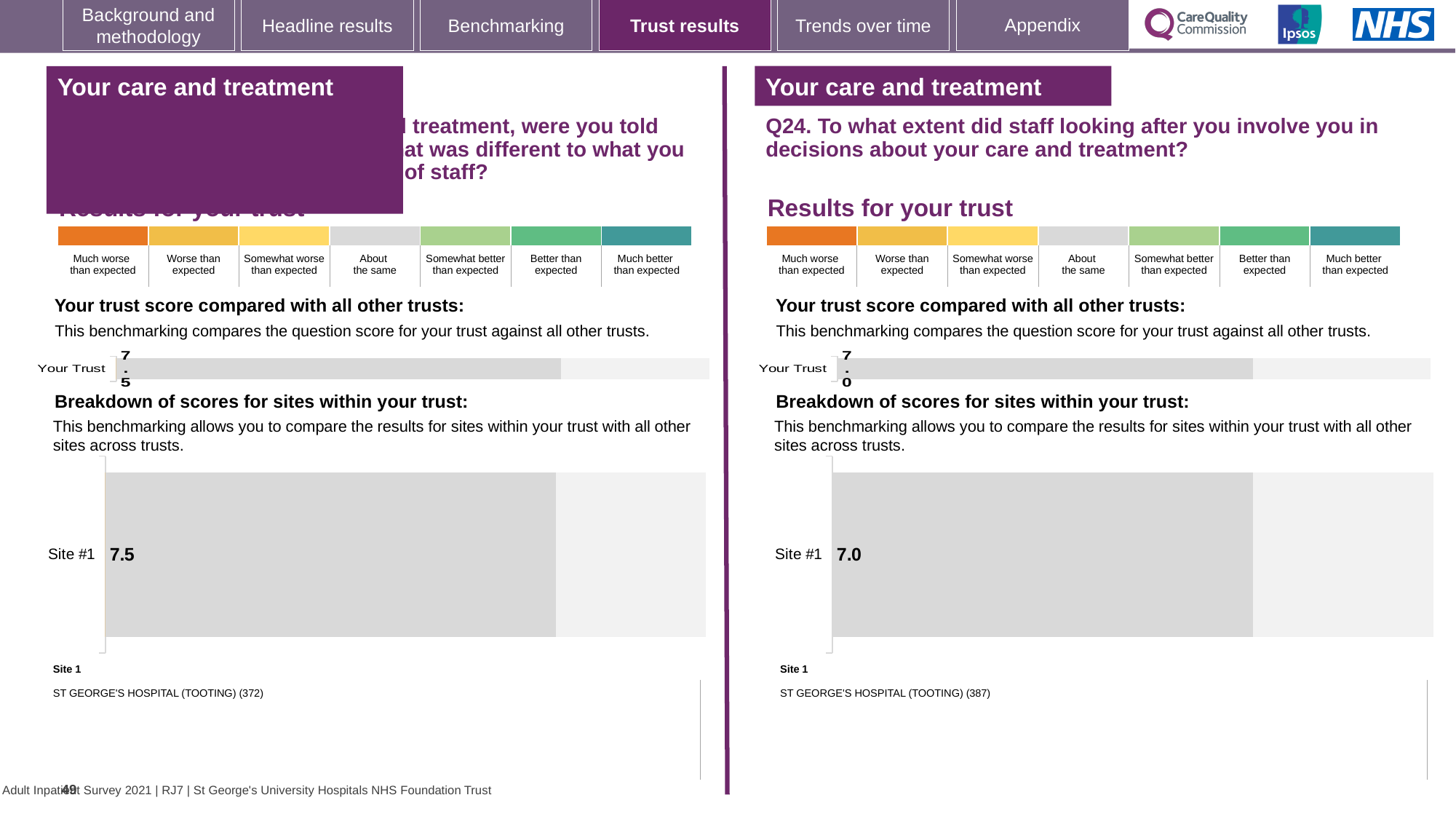
How many sites are plotted in the right-hand (Q24) 'Breakdown of scores for sites within your trust' chart? 1 What is the difference between the Site #1 score in the left-hand site breakdown chart (7.5) and the Site #1 score in the right-hand (Q24) site breakdown chart (7.0)? 0.5 In the right-hand (Q24) 'Your trust score compared with all other trusts' chart, what is the value for Your Trust? 7.0 What kind of chart is used for the 'Your trust score compared with all other trusts' section on the right-hand (Q24) side? Bar chart How many sites are plotted in the left-hand 'Breakdown of scores for sites within your trust' chart? 1 In the right-hand (Q24) site breakdown, what number is shown in brackets after ST GEORGE'S HOSPITAL (TOOTING) for Site 1? 387 In the left-hand 'Breakdown of scores for sites within your trust' chart, what is the score for Site #1? 7.5 In the right-hand (Q24) site breakdown, which hospital is listed as Site 1? ST GEORGE'S HOSPITAL (TOOTING) Which is larger: the Your Trust value in the left-hand trust score chart or the Your Trust value in the right-hand (Q24) trust score chart? Left-hand chart (7.5) In the right-hand (Q24) 'Breakdown of scores for sites within your trust' chart, what is the score for Site #1? 7.0 In the left-hand 'Your trust score compared with all other trusts' chart, what is the value for Your Trust? 7.5 Which is larger: the Site #1 score in the left-hand site breakdown chart or the Site #1 score in the right-hand (Q24) site breakdown chart? Left-hand chart (7.5)